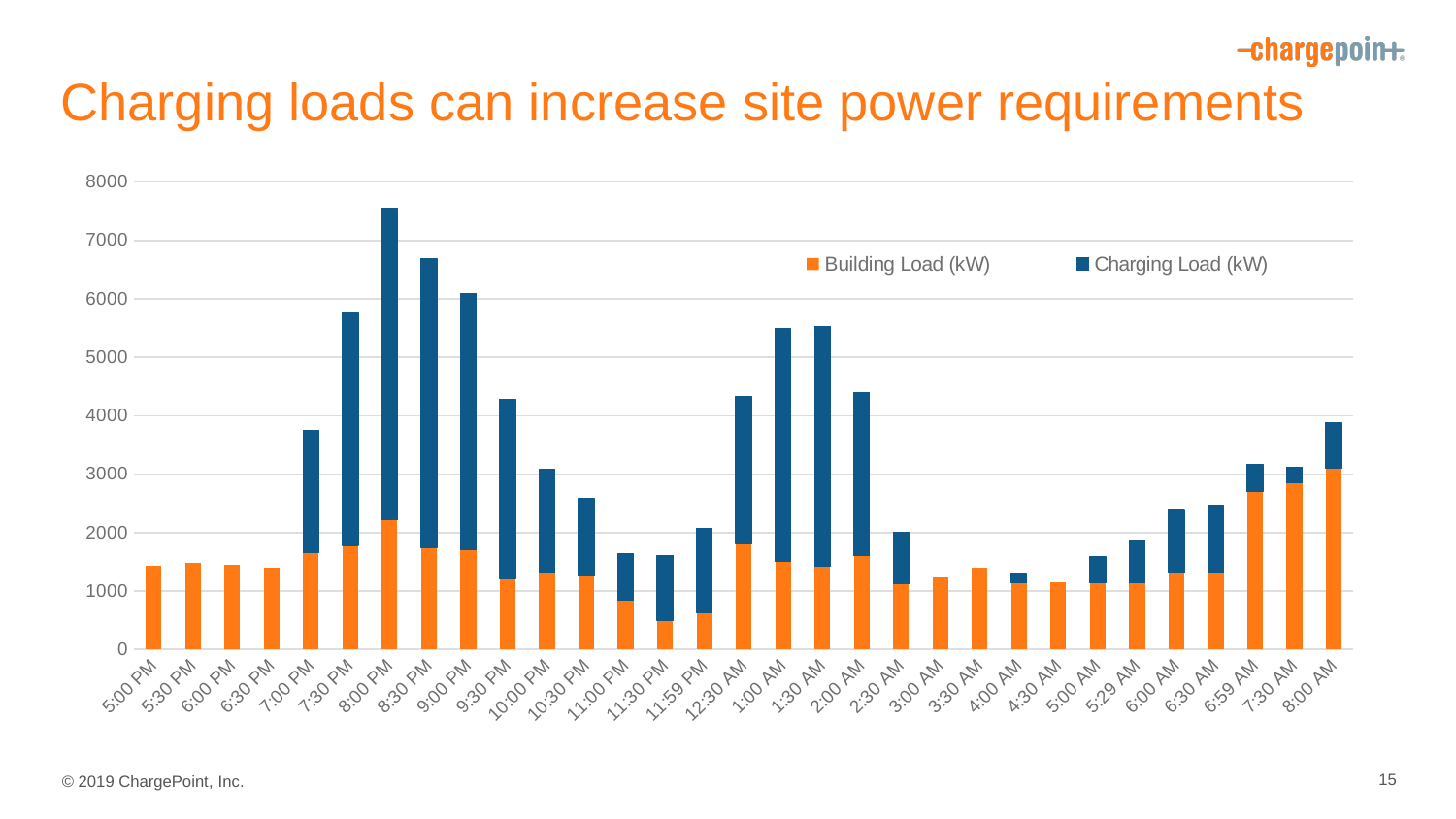
What are the two series named in the legend? Building Load (kW) and Charging Load (kW) Do the total stacked bars rise or fall from 5:00 AM to 8:00 AM? rise Is the total stacked bar at 7:00 PM greater or less than 4000? less Is the Building Load (kW) value at 11:30 PM greater or less than 1000? less Which colour represents Charging Load (kW) in the chart? Blue Which has the larger total stacked bar, 8:00 PM or 8:30 PM? 8:00 PM Is the total stacked bar at 8:00 PM greater or less than 7000? greater At which time is the total stacked bar (building plus charging load) highest? 8:00 PM What kind of chart is shown on the slide? Stacked bar chart How many series does the legend list? 2 How many time categories are shown on the x axis? 31